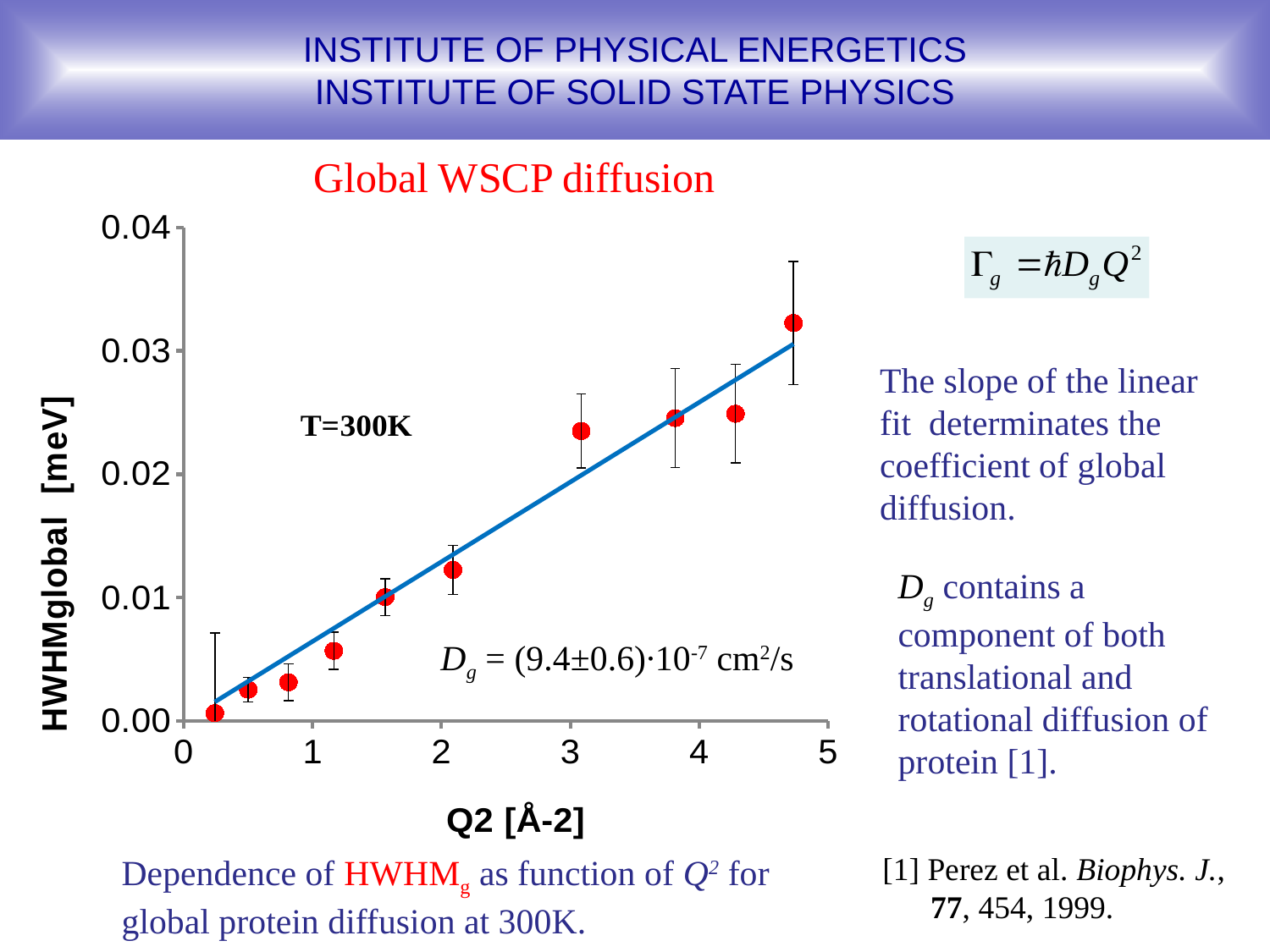
Is the value of the rightmost data point (near Q2 = 4.75) greater or less than 0.03? greater Is the value of the data point near Q2 = 2.1 greater or less than 0.01? greater Do the HWHMglobal values rise or fall as Q2 increases? rise What is the highest value shown on the y axis? 0.04 How many data points are plotted on the chart? 10 Which data point has the highest HWHMglobal value, the leftmost or the rightmost? the rightmost Is the value of the data point near Q2 = 3.1 greater or less than 0.02? greater What is the label of the y axis? HWHMglobal [meV] What is the title of the chart? Global WSCP diffusion Which is larger, the HWHMglobal value of the point near Q2 = 3.1 or the point near Q2 = 1.55? the point near Q2 = 3.1 What kind of chart is shown on the slide? scatter chart